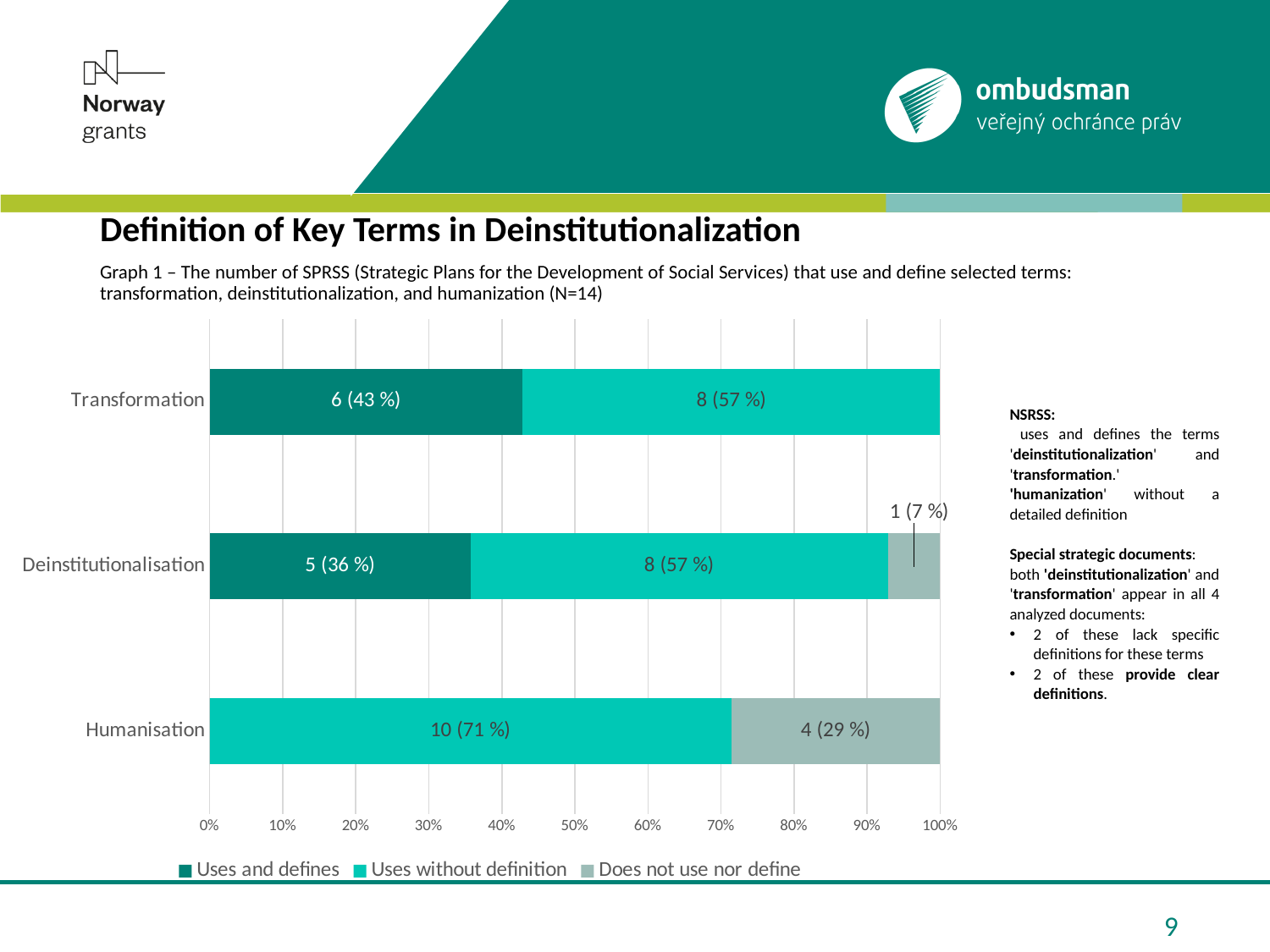
How many series does the chart legend list? 3 Which category has the highest count for 'Uses without definition'? Humanisation What is the data label for 'Uses and defines' in the Transformation bar? 6 (43 %) What is the title of the graph as given in the caption above the chart? Graph 1 – The number of SPRSS (Strategic Plans for the Development of Social Services) that use and define selected terms: transformation, deinstitutionalization, and humanization (N=14) Which category has the lowest count for 'Uses and defines'? Humanisation What is the data label for 'Does not use nor define' in the Humanisation bar? 4 (29 %) What kind of chart is shown on the slide? Stacked bar chart What is the data label for 'Does not use nor define' in the Deinstitutionalisation bar? 1 (7 %) Which is larger: the 'Uses and defines' count for Transformation or for Deinstitutionalisation? Transformation How many categories are plotted on the chart? 3 What is the data label for 'Uses without definition' in the Deinstitutionalisation bar? 8 (57 %) How many more SPRSS use 'Humanisation' without definition than use 'Transformation' without definition? 2